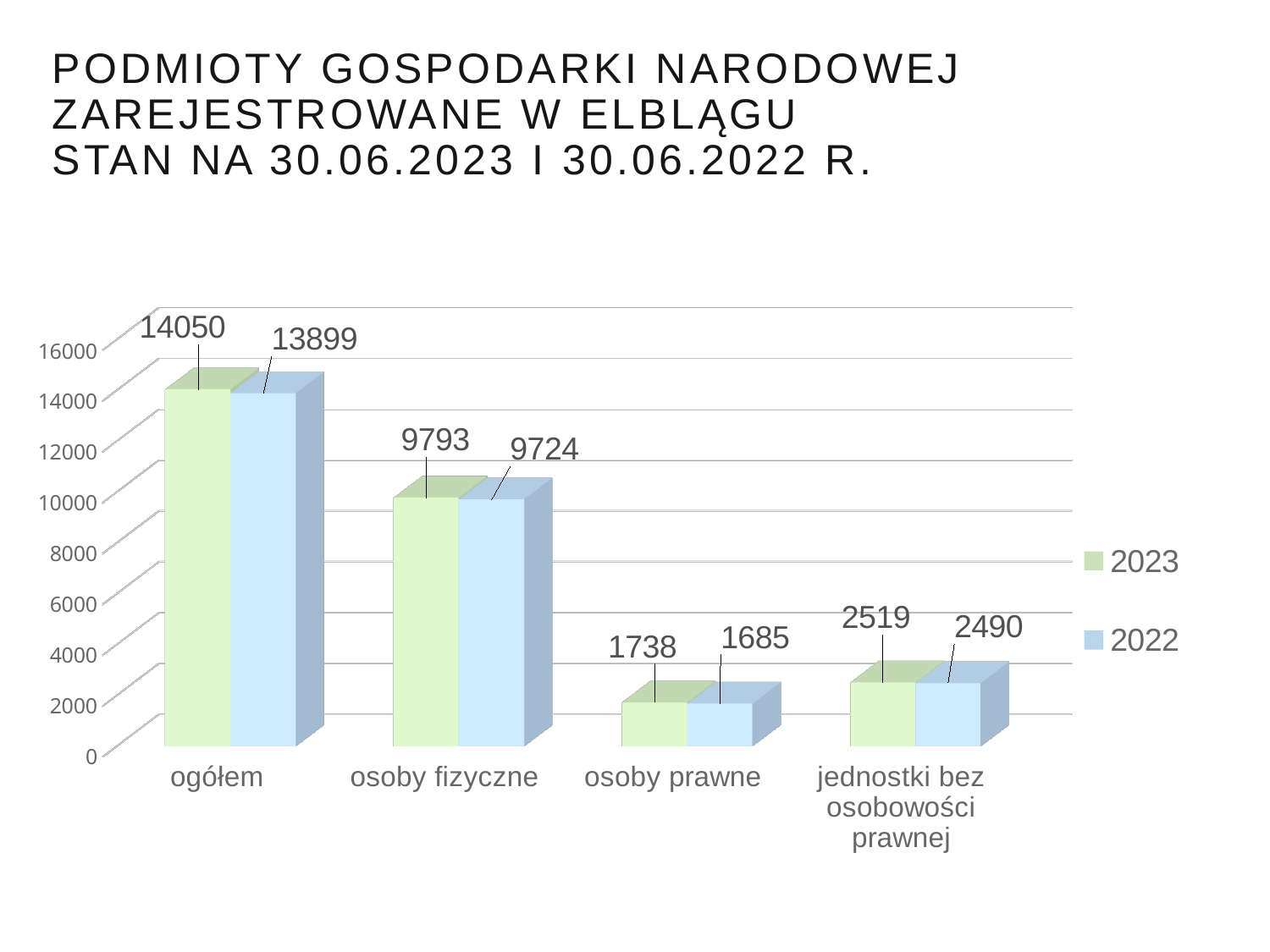
Which category has the highest value for 2023? ogółem What is the value for 2023 in the ogółem category? 14050 What is the value for 2022 in the osoby fizyczne category? 9724 What kind of chart is shown on the slide? bar chart What is the difference between the 2023 and 2022 values for ogółem? 151 What is the value for 2022 in the jednostki bez osobowości prawnej category? 2490 How many categories are shown on the x axis? 4 How many series does the legend list? 2 What is the value for 2023 in the osoby prawne category? 1738 What is the difference between the 2023 and 2022 values for osoby prawne? 53 Which category has the lowest value for 2022? osoby prawne Which is larger for jednostki bez osobowości prawnej, the 2023 value or the 2022 value? 2023